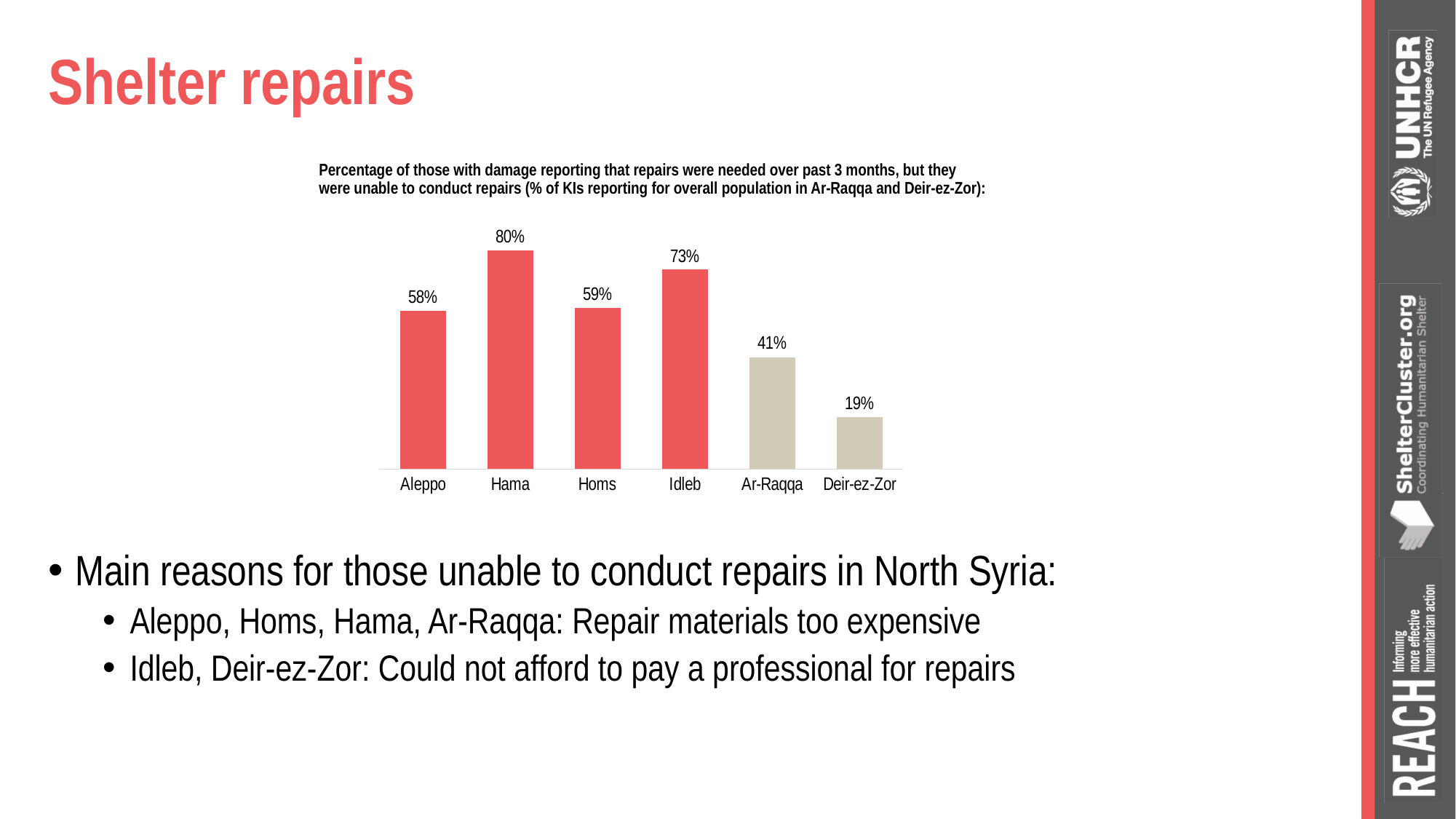
Which is larger, the value for Idleb or the value for Homs? Idleb What is the value for Deir-ez-Zor? 19% How many categories are shown on the x axis? 6 Which category has the lowest value? Deir-ez-Zor Which two categories are shown with beige bars rather than red bars? Ar-Raqqa and Deir-ez-Zor Which category has the highest value? Hama What is the value for Ar-Raqqa? 41% What is the difference between the values for Hama and Aleppo? 22% What kind of chart is shown on the slide? Bar chart What is the value for Idleb? 73% What is the difference between the values for Ar-Raqqa and Deir-ez-Zor? 22% What is the value for Hama? 80%